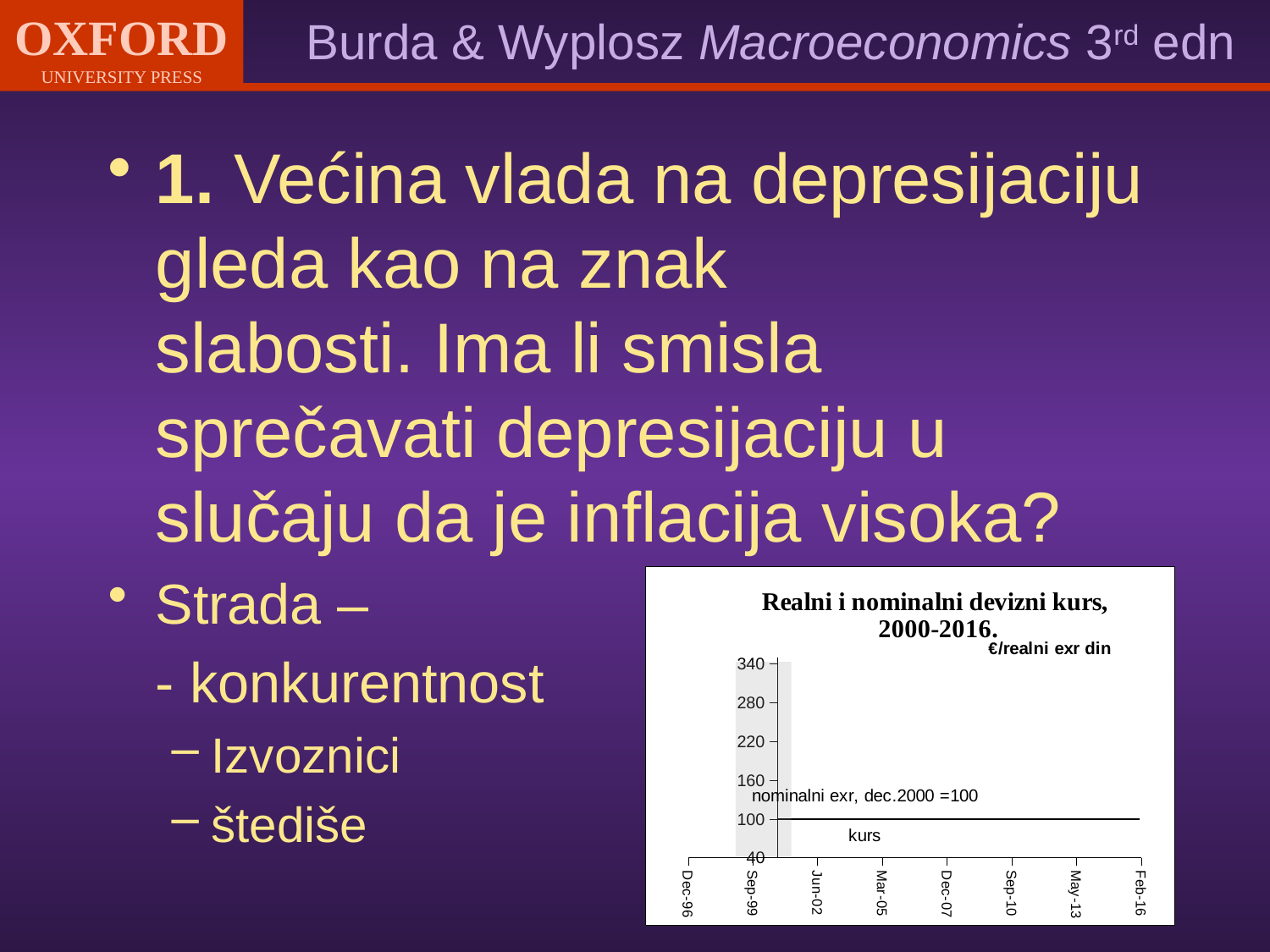
What is the first x-axis tick label on the chart? Dec-96 What is the lowest value shown on the y axis of the chart? 40 What base-year note is written next to the nominal exchange rate line in the chart? nominalni exr, dec.2000 =100 Does the horizontal line in the chart rise, fall, or stay flat from left to right? stay flat What is the title of the chart on the slide? Realni i nominalni devizni kurs, 2000-2016. At what y-axis value does the flat horizontal line in the chart sit? 100 What is the highest value shown on the y axis of the chart? 340 Is the horizontal line in the chart above or below 160? below What is the last x-axis tick label on the chart? Feb-16 How many tick labels are shown on the x axis of the chart? 8 What kind of chart is shown on the slide? line chart